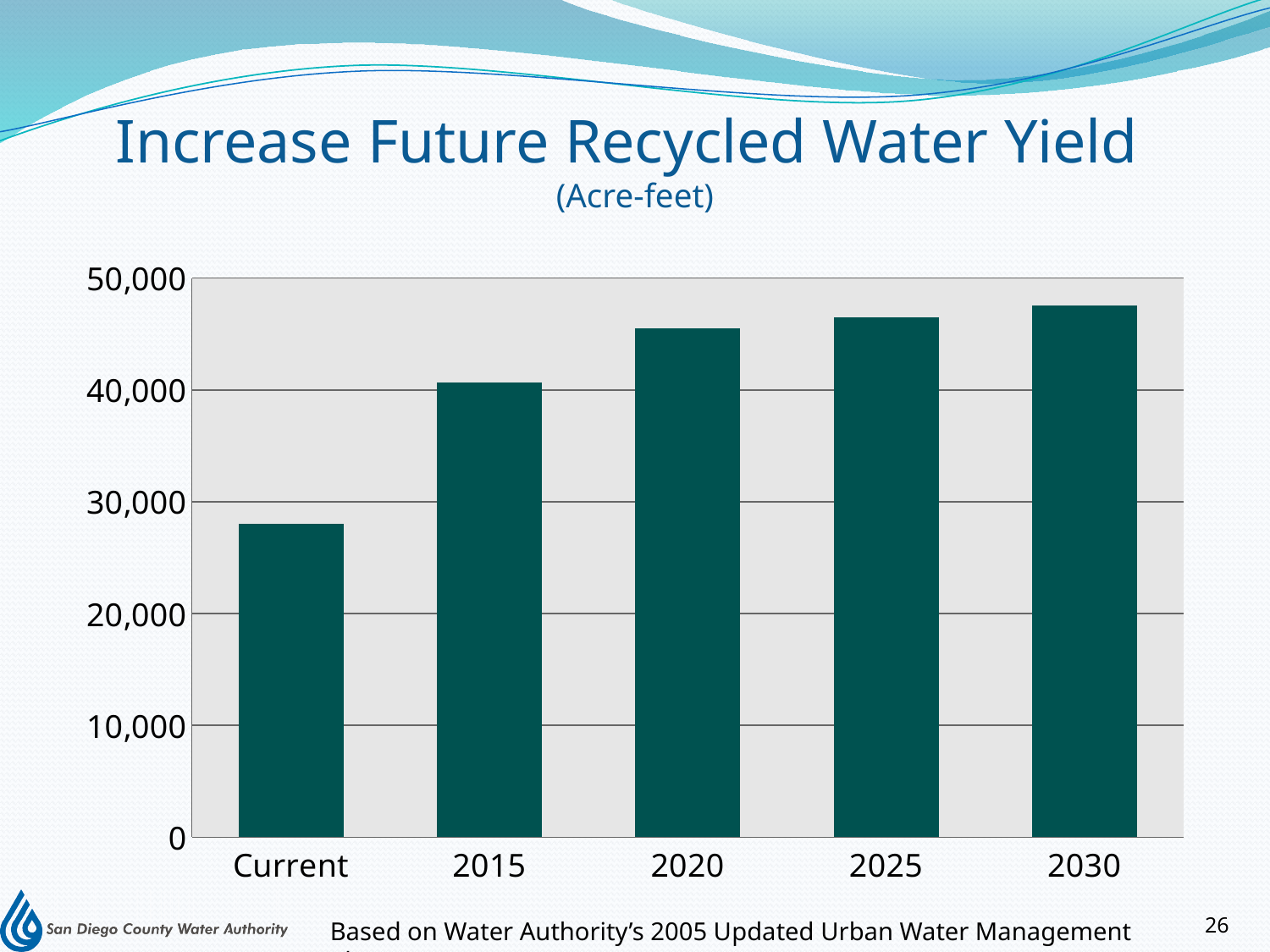
How many categories are shown on the x axis of the chart? 5 Do the values rise or fall from Current to 2030 along the x axis? rise Which is larger, the value for Current or the value for 2015? 2015 Which category has the lowest recycled water yield? Current Is the value for 2020 greater or less than 40,000? greater What kind of chart is shown on the slide? bar chart Is the value for 2025 greater or less than 40,000? greater Is the value for Current greater or less than 30,000? less What unit is given in the chart's subtitle? Acre-feet Which is larger, the value for 2015 or the value for 2020? 2020